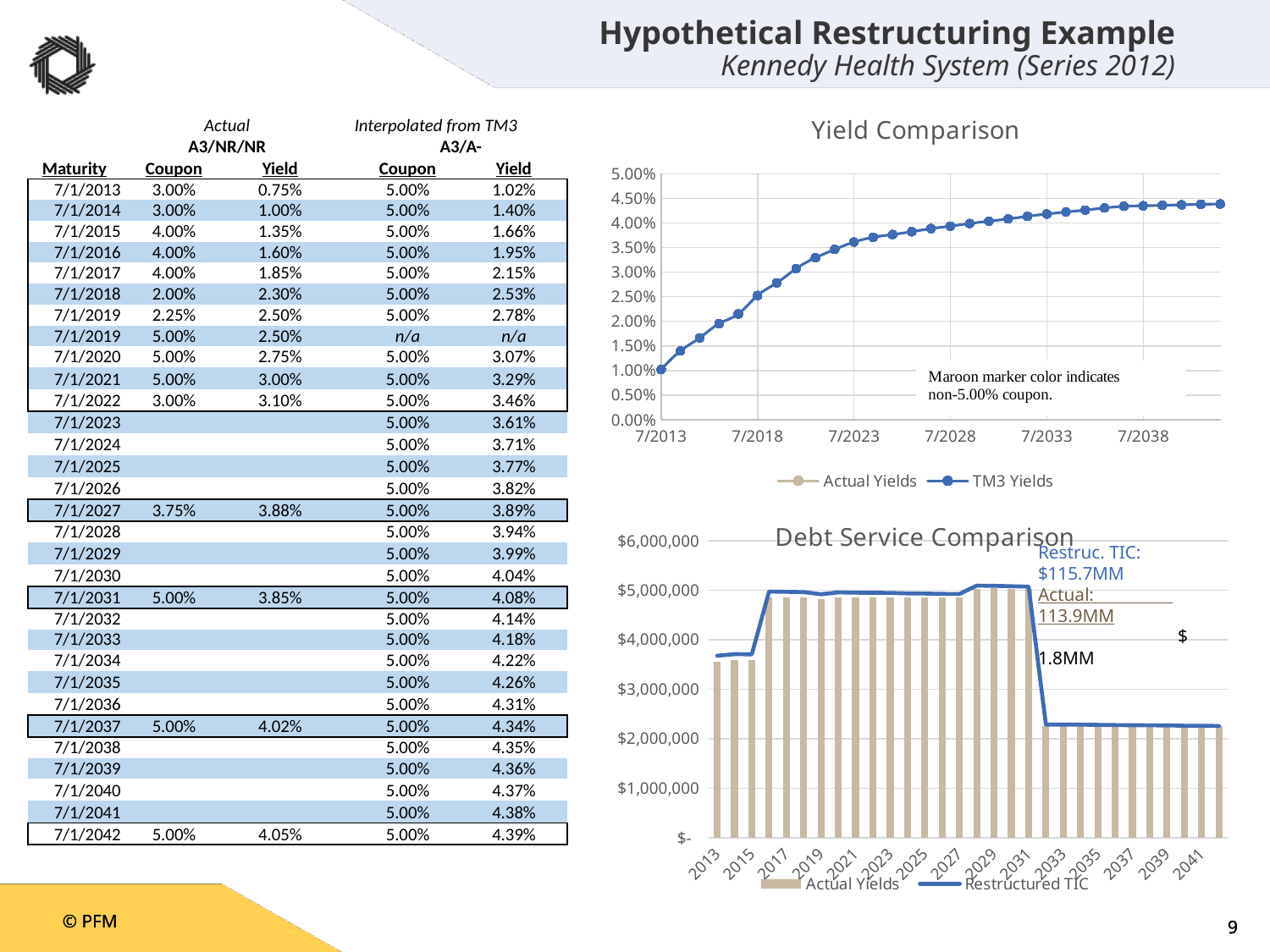
In the Debt Service Comparison chart, is the Actual Yields bar for 2013 greater or less than $4,000,000? less In the Yield Comparison chart, do the TM3 Yields rise or fall from 7/2013 to 7/2038? rise In the Yield Comparison chart, is the TM3 Yields value at 7/2038 greater or less than 4.00%? greater In the Debt Service Comparison chart, is the Restructured TIC value for 2035 greater or less than $3,000,000? less What are the two series named in the legend of the Yield Comparison chart? Actual Yields and TM3 Yields How many series does the legend of the Debt Service Comparison chart list? 2 In the Debt Service Comparison chart, what kind of chart is used for the Actual Yields series? bar chart How many series does the legend of the Yield Comparison chart list? 2 What kind of chart is the Yield Comparison chart? line chart In the Debt Service Comparison chart, which is larger: the Actual Yields bar for 2013 or the Actual Yields bar for 2020? 2020